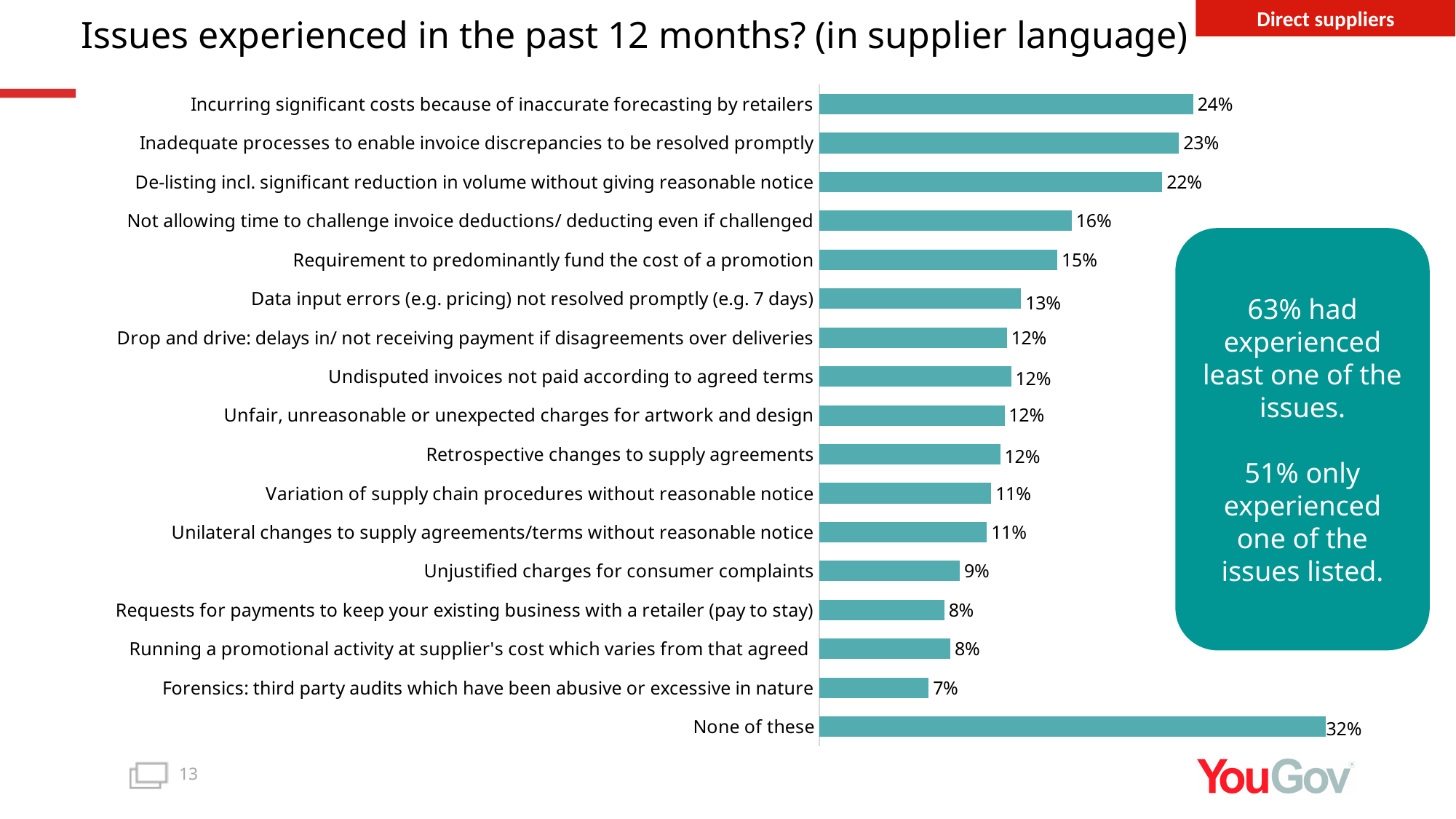
What is the value for 'Requirement to predominantly fund the cost of a promotion'? 15% What percentage of direct suppliers reported incurring significant costs because of inaccurate forecasting by retailers? 24% What is the difference between the value for 'None of these' and the value for 'Incurring significant costs because of inaccurate forecasting by retailers'? 8% Which category has the highest value in the chart? None of these Which is larger: the value for 'De-listing incl. significant reduction in volume without giving reasonable notice' or the value for 'Not allowing time to challenge invoice deductions/ deducting even if challenged'? De-listing incl. significant reduction in volume without giving reasonable notice What kind of chart is shown on the slide? Bar chart What is the title of the chart on the slide? Issues experienced in the past 12 months? (in supplier language) How many categories are shown in the chart? 17 What is the value for 'None of these'? 32% What is the difference between the value for 'Unjustified charges for consumer complaints' and the value for 'Running a promotional activity at supplier's cost which varies from that agreed'? 1% What percentage reported forensics: third party audits which have been abusive or excessive in nature? 7% Which category has the lowest value in the chart? Forensics: third party audits which have been abusive or excessive in nature